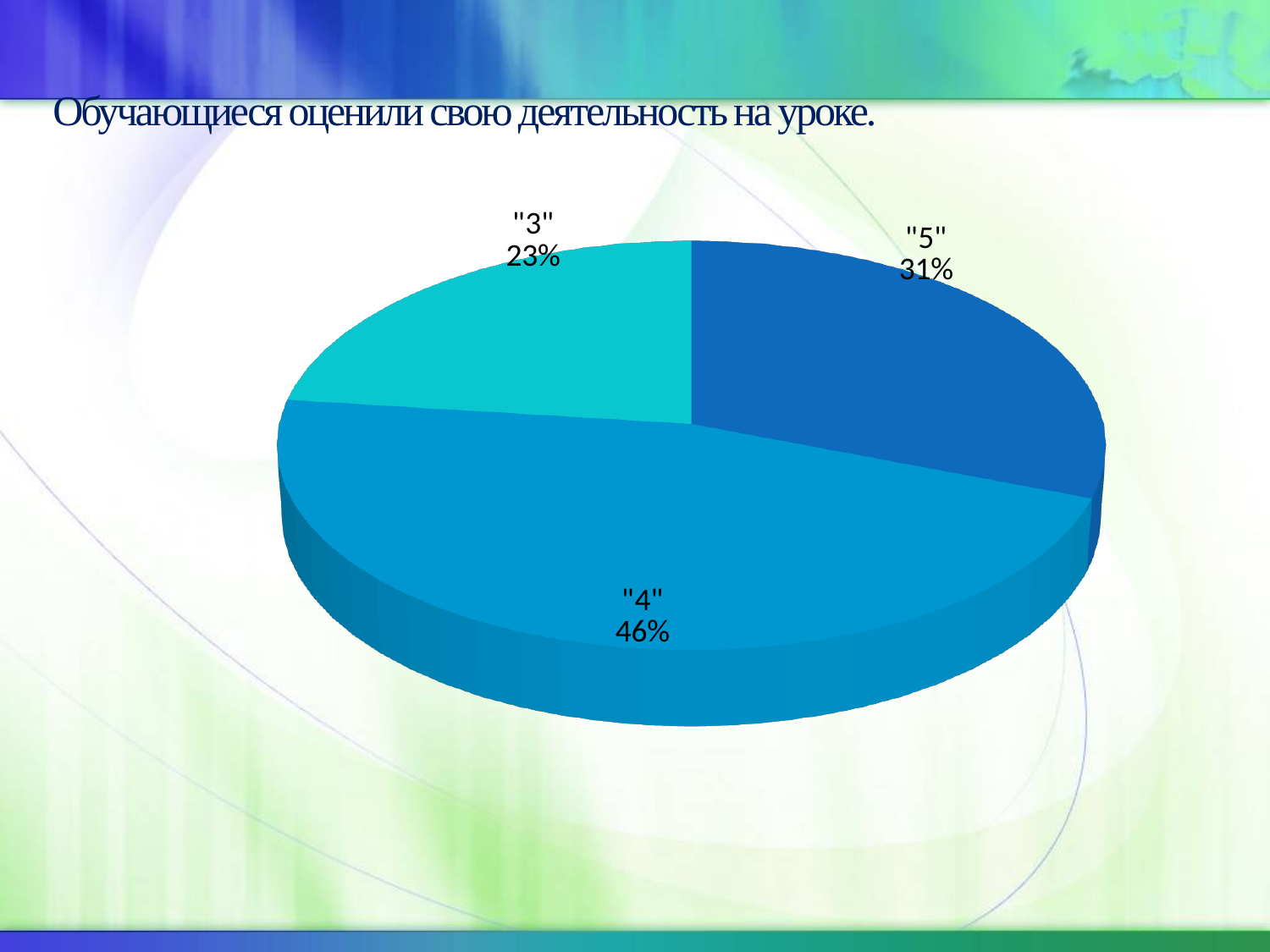
What kind of chart is shown on the slide? pie chart Which slice is shown in the darkest blue colour? "5" What is the difference in percentage points between the "4" slice and the "5" slice? 15 What share of the pie does the "4" slice have? 46% Which slice is the largest? "4" Which is larger, the "5" slice or the "3" slice? "5" What share of the pie does the "5" slice have? 31% What share of the pie does the "3" slice have? 23% Which slice is the smallest? "3" What is the title of the slide above the chart? Обучающиеся оценили свою деятельность на уроке. How many slices does the pie chart have? 3 What is the difference in percentage points between the "5" slice and the "3" slice? 8